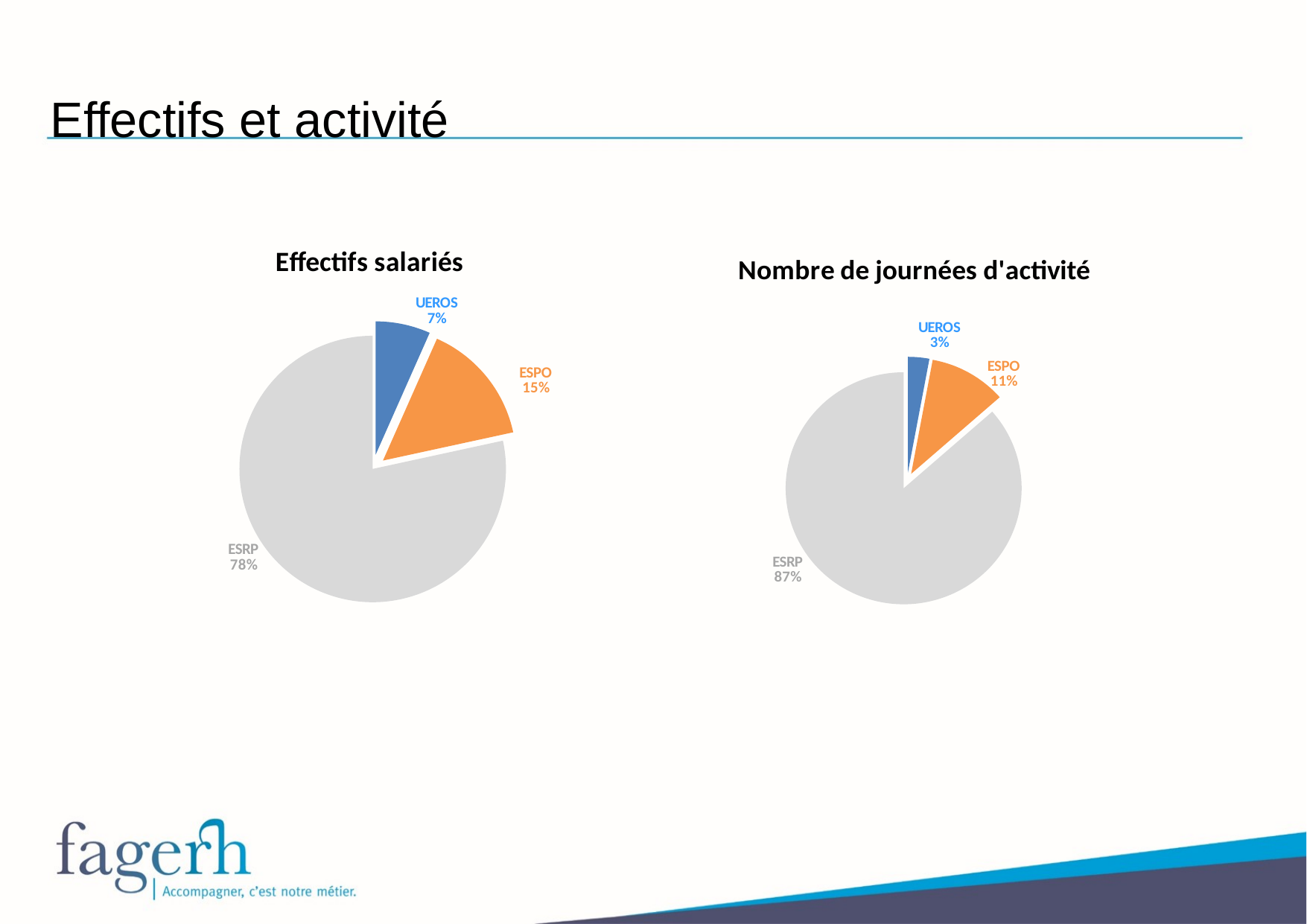
Which is larger: the UEROS share in the 'Effectifs salariés' chart or the UEROS share in the 'Nombre de journées d'activité' chart? Effectifs salariés What kind of chart is the 'Nombre de journées d'activité' chart? Pie chart In the 'Effectifs salariés' chart, which category has the largest share? ESRP In the 'Nombre de journées d'activité' chart, what is the difference between the ESRP and ESPO shares? 76% In the 'Nombre de journées d'activité' chart, what share does ESRP have? 87% In the 'Effectifs salariés' chart, what share does ESRP have? 78% What colour is the ESPO slice in the 'Effectifs salariés' chart? Orange In the 'Nombre de journées d'activité' chart, what share does UEROS have? 3% How many categories does the 'Effectifs salariés' chart show? 3 In the 'Nombre de journées d'activité' chart, which category has the smallest share? UEROS In the 'Effectifs salariés' chart, what is the difference between the ESPO and UEROS shares? 8% In the 'Effectifs salariés' chart, what share does ESPO have? 15%